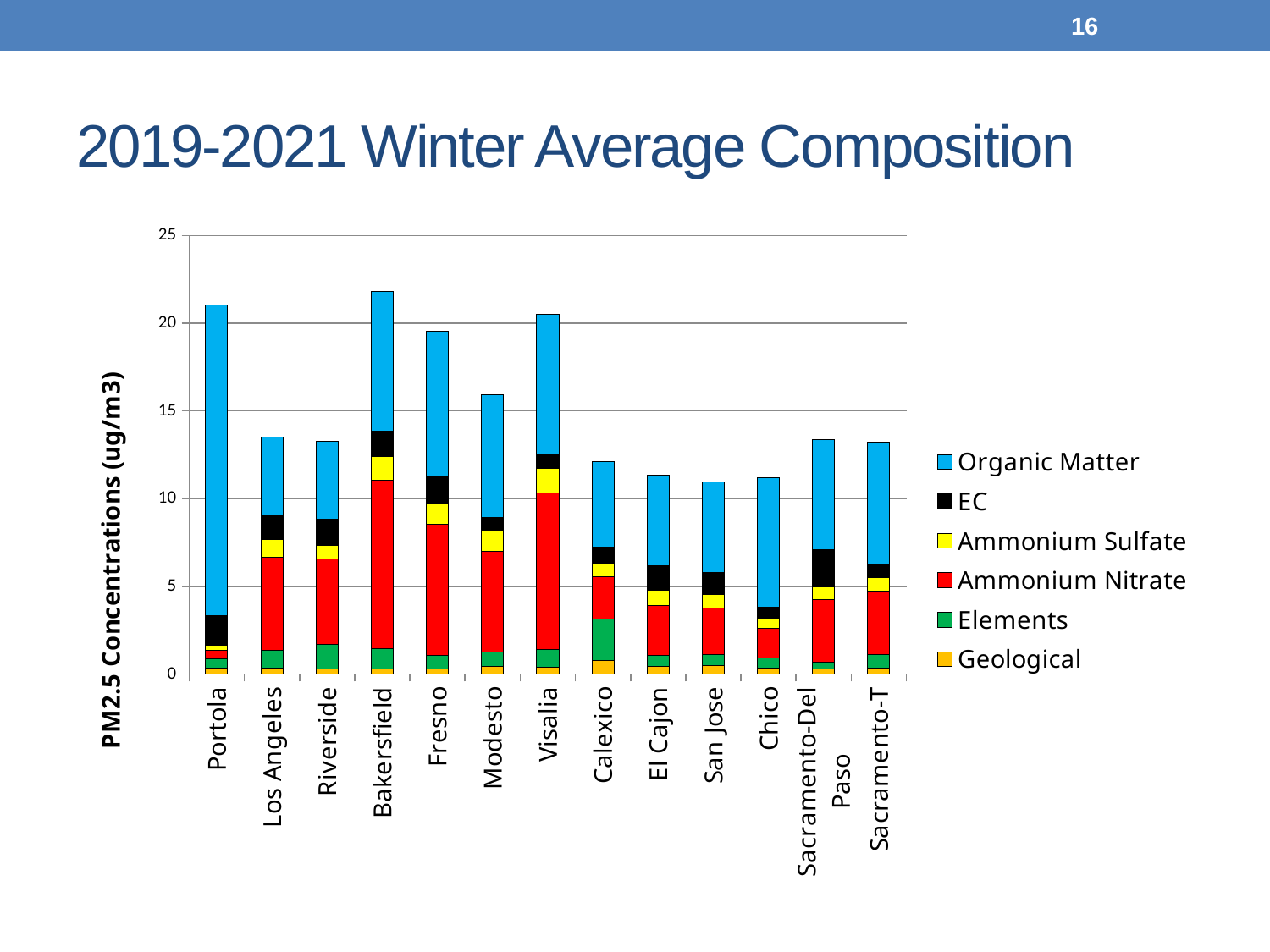
How many cities (categories) are shown on the x axis of the chart? 13 What is the label on the y axis of the chart? PM2.5 Concentrations (ug/m3) Which series is shown in blue in the chart's legend? Organic Matter What kind of chart is shown on the slide? Stacked bar chart Which has a larger total PM2.5 concentration, Portola or Los Angeles? Portola Is the total PM2.5 concentration for Portola greater or less than 20? greater Is the total PM2.5 concentration for Calexico greater or less than 15? less Which city has the highest total PM2.5 concentration in the chart? Bakersfield Is the total PM2.5 concentration for Fresno greater or less than 15? greater Which has a larger total PM2.5 concentration, Fresno or Modesto? Fresno How many series does the chart's legend list? 6